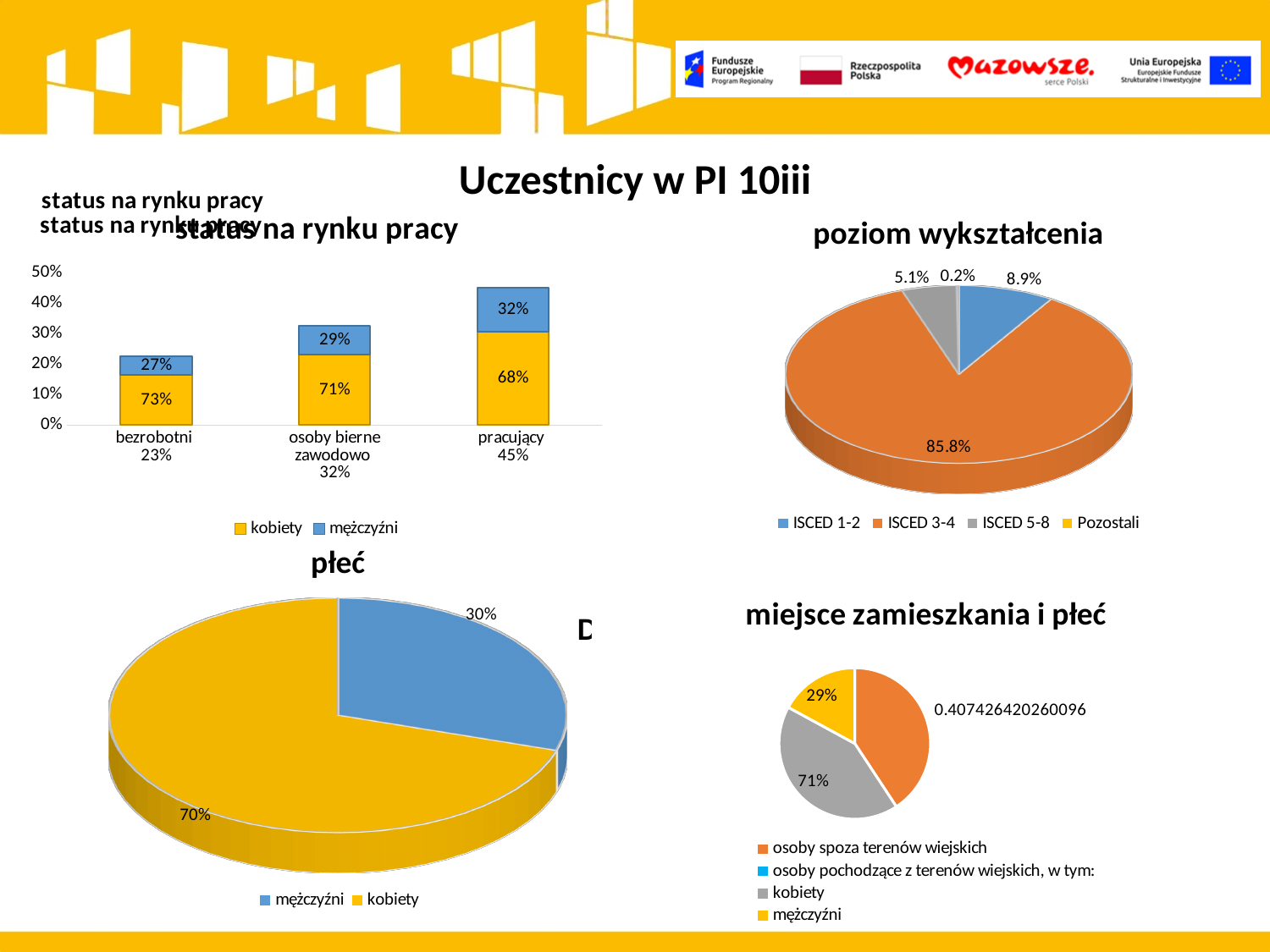
In the 'status na rynku pracy' chart, how many categories are shown on the x axis? 3 In the 'status na rynku pracy' chart, what is the value for mężczyźni in the osoby bierne zawodowo category? 29% In the 'poziom wykształcenia' chart, what is the share for ISCED 3-4? 85.8% In the 'status na rynku pracy' chart, what is the value for mężczyźni in the pracujący category? 32% In the 'status na rynku pracy' chart, what is the value for kobiety in the bezrobotni category? 73% What kind of chart is 'status na rynku pracy'? bar chart In the 'poziom wykształcenia' chart, which is larger, ISCED 1-2 or ISCED 5-8? ISCED 1-2 In the 'status na rynku pracy' chart, what is the difference between the kobiety and mężczyźni values in the bezrobotni category? 46% In the 'płeć' chart, what is the share for kobiety? 70% How many entries does the legend of the 'poziom wykształcenia' chart list? 4 In the 'poziom wykształcenia' chart, which category has the smallest share? Pozostali In the 'miejsce zamieszkania i płeć' chart, what is the value shown for the kobiety slice? 71%